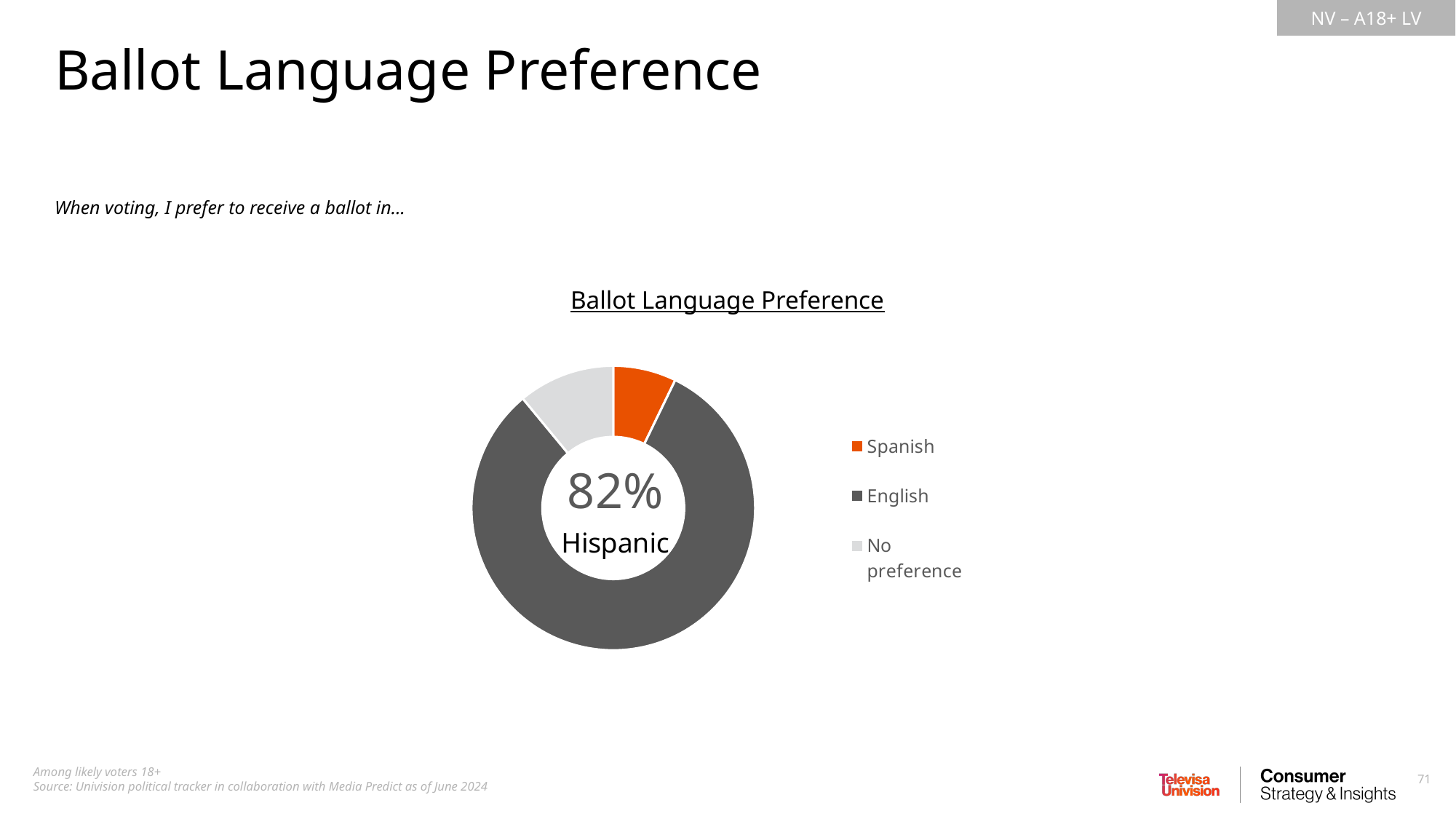
Which ballot language preference has the smallest slice of the donut chart? Spanish Which slice is larger, English or Spanish? English What kind of chart is shown on the slide? Donut (pie) chart Which ballot language preference has the largest slice of the donut chart? English Which category is shown in orange in the donut chart? Spanish Which slice is larger, No preference or Spanish? No preference What word appears below the percentage in the centre of the donut chart? Hispanic How many entries does the legend list? 3 How many categories does the donut chart show? 3 What is the title of the chart? Ballot Language Preference What percentage is printed in the centre of the donut chart? 82%